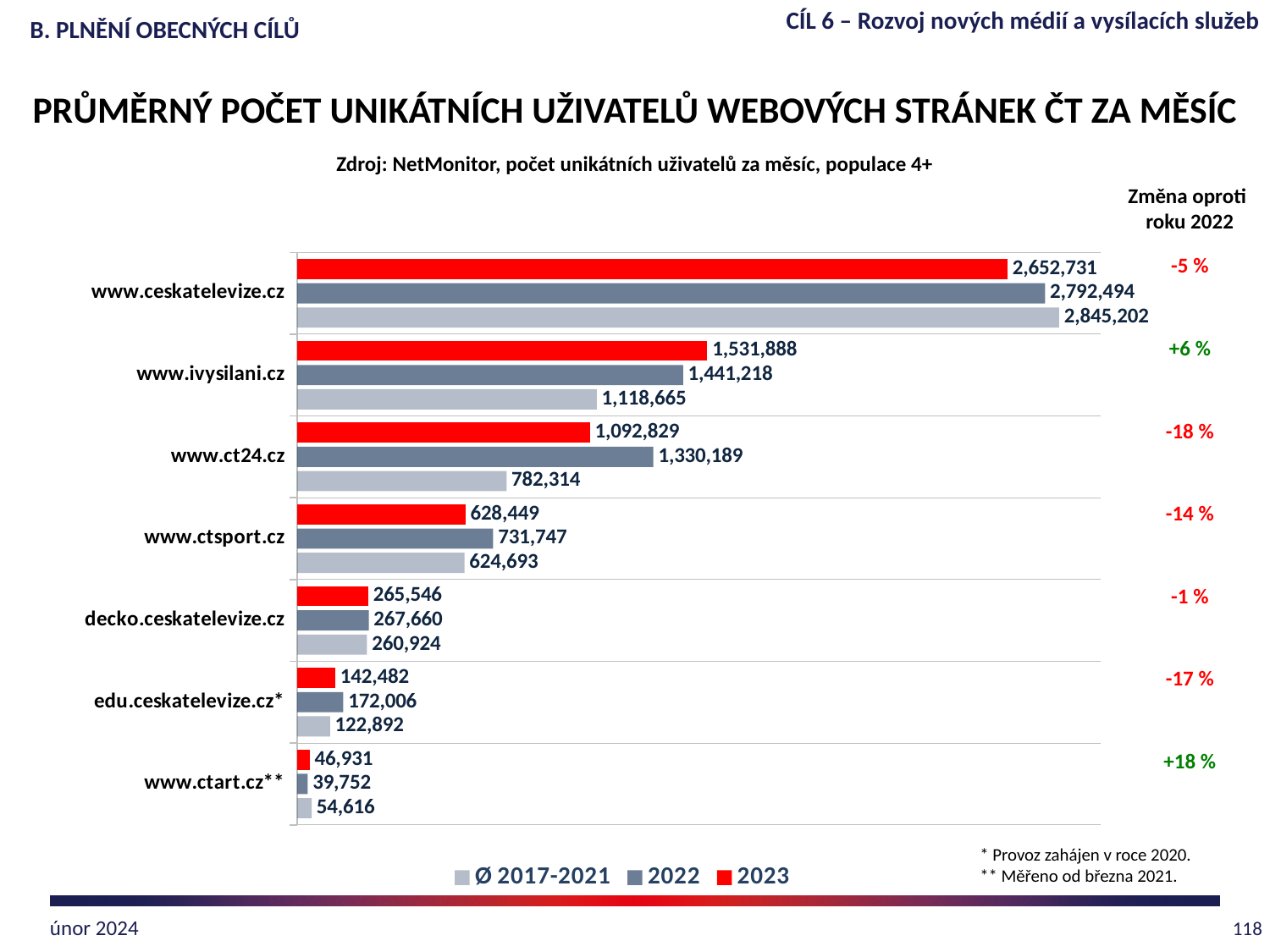
What is the difference between the 2022 and 2023 values for www.ceskatelevize.cz? 139,763 What is the difference between the 2023 and 2022 values for www.ivysilani.cz? 90,670 Which website has the lowest 2023 value? www.ctart.cz** Which website has the highest 2023 value? www.ceskatelevize.cz What change compared to 2022 is shown for www.ctart.cz**? +18 % What is the Ø 2017-2021 value for decko.ceskatelevize.cz? 260,924 How many websites are shown in the chart? 7 What is the 2023 value for www.ivysilani.cz? 1,531,888 What kind of chart is shown on the slide? bar chart Which has the larger 2023 value, www.ct24.cz or www.ctsport.cz? www.ct24.cz What is the 2022 value for www.ct24.cz? 1,330,189 How many series does the legend list? 3